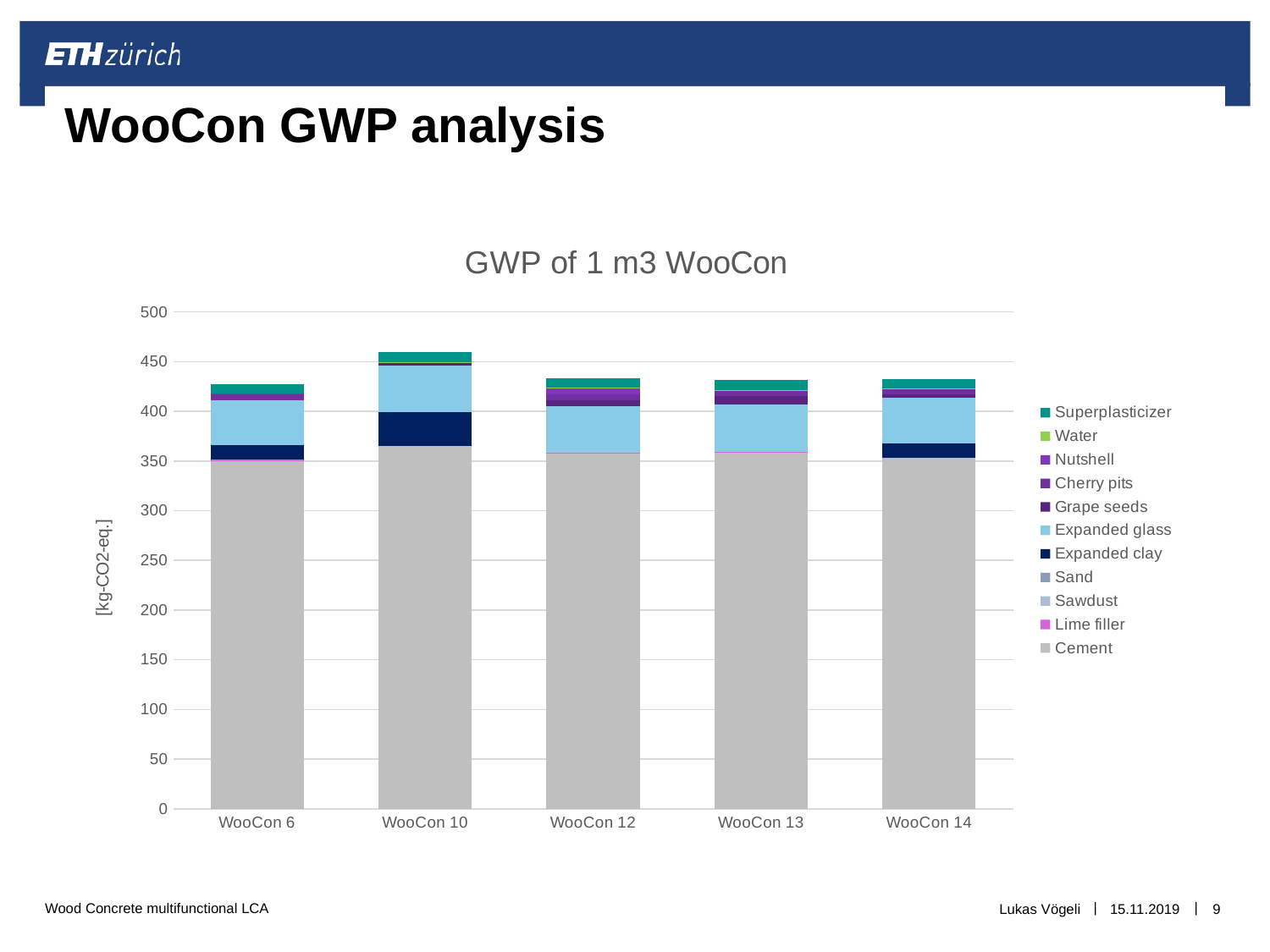
Which WooCon mix has the highest total GWP? WooCon 10 Which has the larger total GWP, WooCon 10 or WooCon 6? WooCon 10 What is the title of the chart? GWP of 1 m3 WooCon Which series forms the bottom (largest) segment of every bar? Cement What type of chart is shown on the slide? Stacked bar chart How many series does the legend list? 11 Is the Cement contribution for WooCon 10 greater or less than 350? greater Is the total GWP for WooCon 12 greater or less than 400? greater Is the total GWP for WooCon 10 greater or less than 450? greater How many WooCon mixes (categories) are plotted on the x axis? 5 What unit is shown on the y axis label? [kg-CO2-eq.]